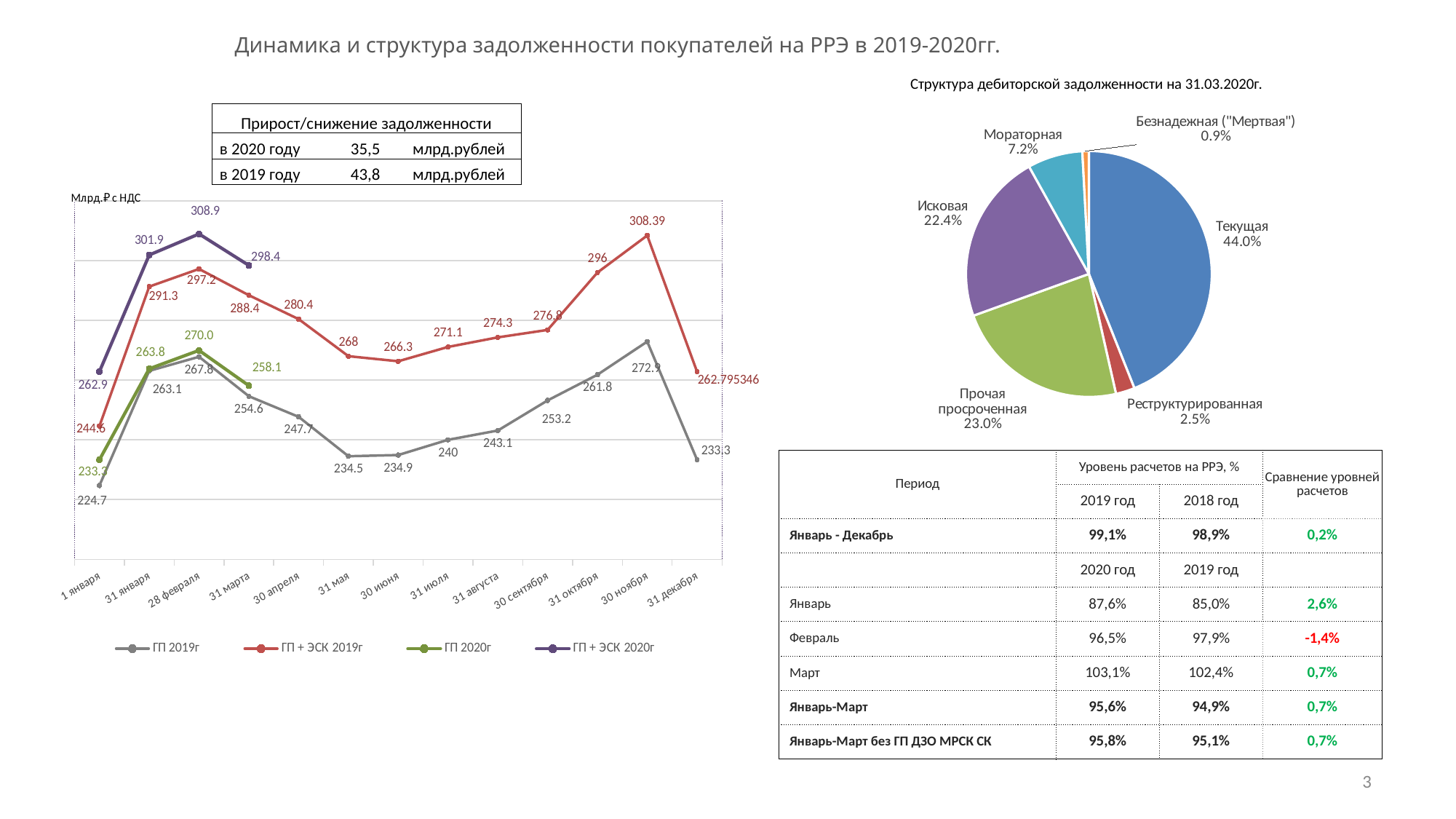
On the line chart, what is the value of ГП 2020г on 31 марта? 258.1 On the pie chart 'Структура дебиторской задолженности на 31.03.2020г.', which slice is the smallest? Безнадежная ("Мертвая") On the line chart, at which date does ГП + ЭСК 2019г reach its highest value? 30 ноября On the line chart, what is the value of ГП + ЭСК 2019г on 30 ноября? 308.39 On the line chart, which is larger on 31 марта: ГП 2019г or ГП 2020г? ГП 2020г On the line chart, what is the value of ГП 2019г on 1 января? 224.7 How many series does the legend of the line chart list? 4 How many slices does the pie chart 'Структура дебиторской задолженности на 31.03.2020г.' have? 6 On the pie chart 'Структура дебиторской задолженности на 31.03.2020г.', what share does Текущая have? 44.0% On the line chart, at which date does ГП 2019г reach its lowest value? 1 января On the line chart, what is the value of ГП + ЭСК 2020г on 28 февраля? 308.9 On the line chart, what is the difference between ГП + ЭСК 2020г and ГП 2020г on 31 января? 38.1